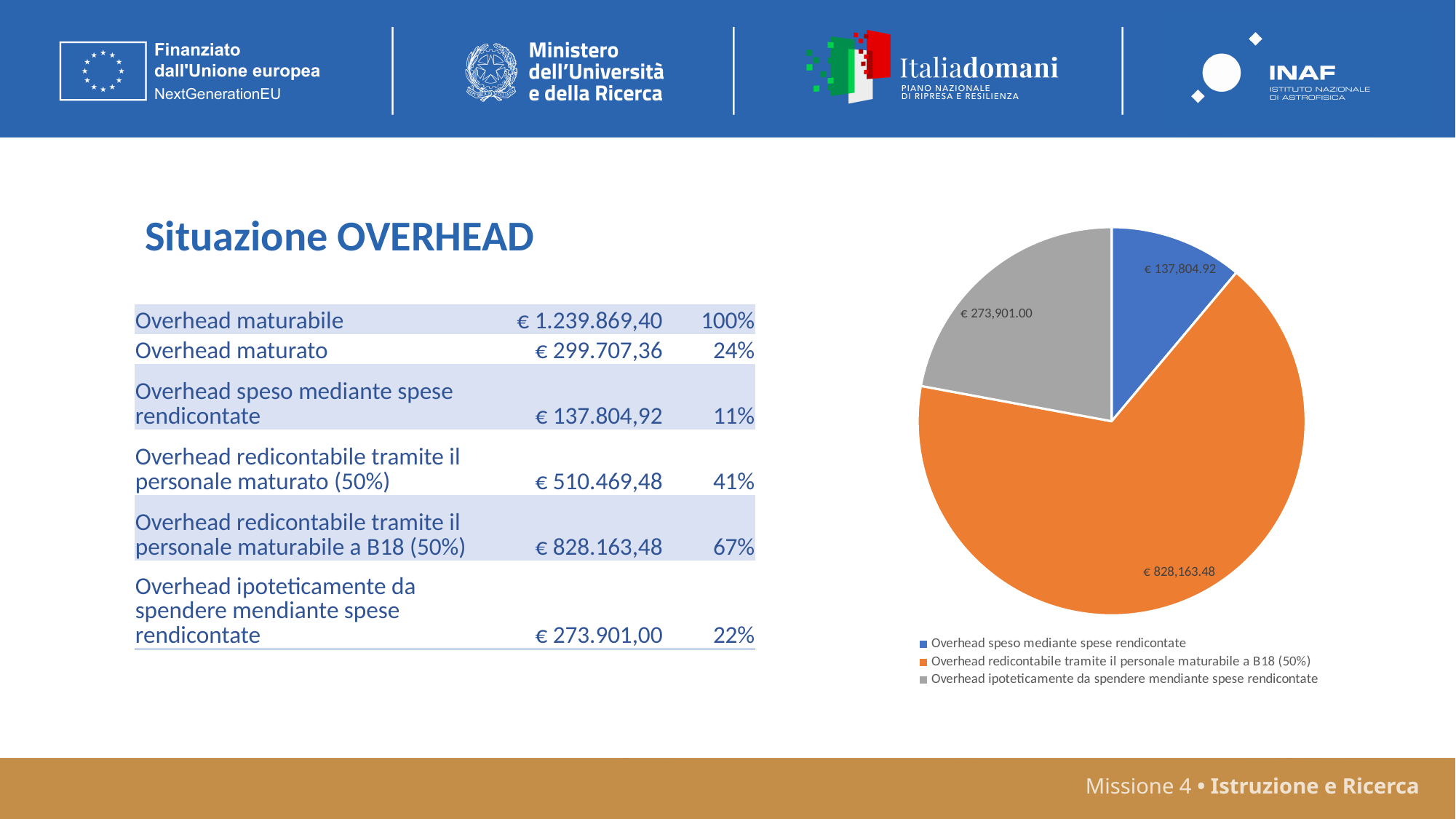
What kind of chart is shown on the slide? pie chart How many entries does the pie chart's legend list? 3 Which slice of the pie chart is the smallest? Overhead speso mediante spese rendicontate In the pie chart, which is larger: the slice for 'Overhead ipoteticamente da spendere mendiante spese rendicontate' or the slice for 'Overhead speso mediante spese rendicontate'? Overhead ipoteticamente da spendere mendiante spese rendicontate Which slice of the pie chart is the largest? Overhead redicontabile tramite il personale maturabile a B18 (50%) What is the difference between the largest and smallest slice values in the pie chart? € 690,358.56 What is the value of the slice for 'Overhead speso mediante spese rendicontate' in the pie chart? € 137,804.92 What is the value of the slice for 'Overhead ipoteticamente da spendere mendiante spese rendicontate' in the pie chart? € 273,901.00 What colour is the slice for 'Overhead ipoteticamente da spendere mendiante spese rendicontate' in the pie chart? gray What share of the pie does the 'Overhead redicontabile tramite il personale maturabile a B18 (50%)' slice represent? 67% How many slices does the pie chart have? 3 What is the value of the slice for 'Overhead redicontabile tramite il personale maturabile a B18 (50%)' in the pie chart? € 828,163.48